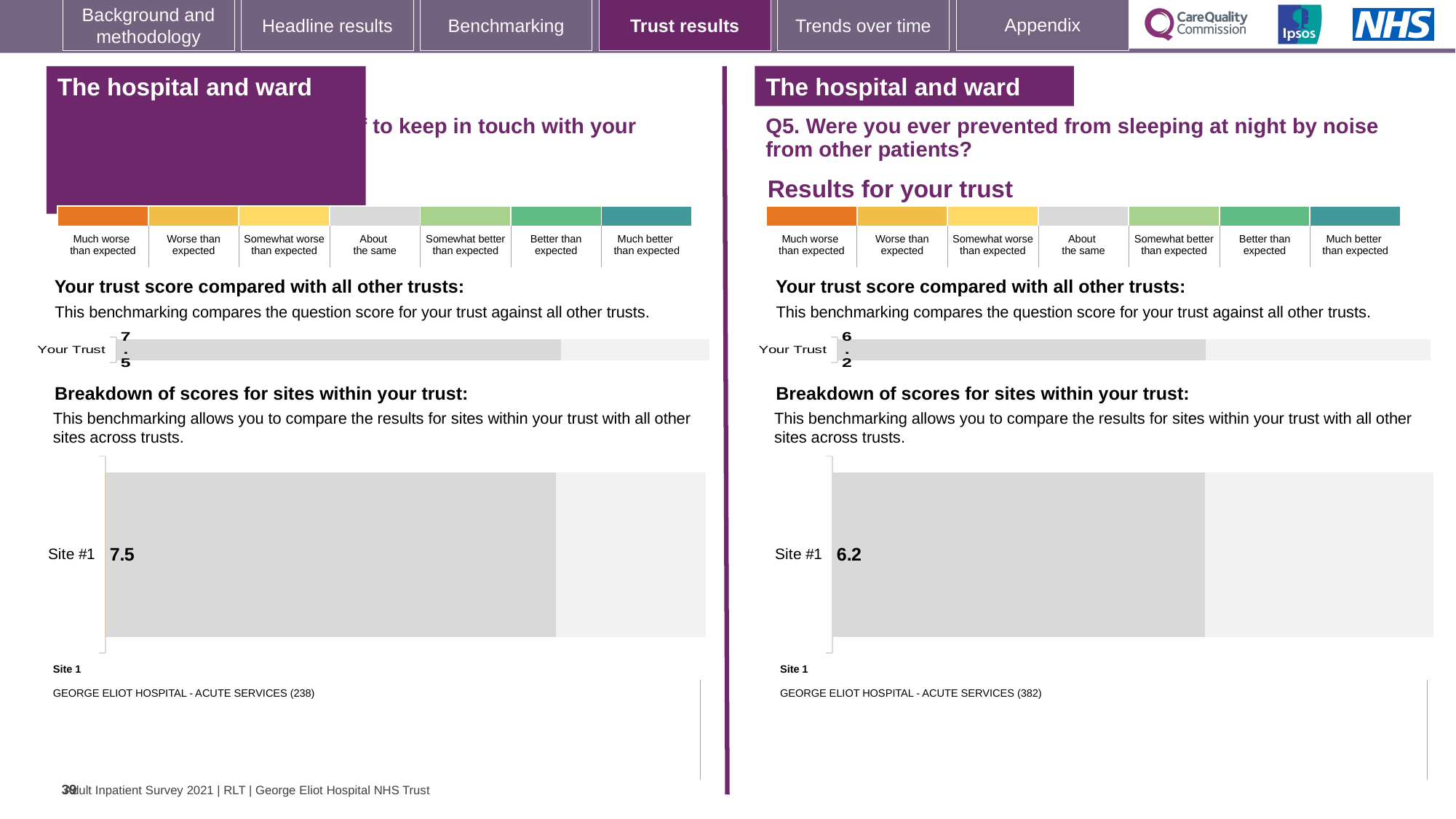
How many sites are shown in the right-hand site breakdown chart for Q5? 1 Which is larger: the Your Trust score on the left-hand chart or the Your Trust score on the right-hand Q5 chart? Left-hand chart (7.5) On the left-hand chart, what is the score shown for Your Trust? 7.5 On the right-hand chart for Q5 (prevented from sleeping at night by noise from other patients), what is the score shown for Your Trust? 6.2 What type of chart is used to show the Site #1 score on the right-hand Q5 panel? Bar chart In the right-hand site breakdown chart for Q5, what score is shown for Site #1? 6.2 How many sites are shown in the left-hand site breakdown chart? 1 What is the difference between the Site #1 score on the left-hand chart (7.5) and the Site #1 score on the right-hand Q5 chart (6.2)? 1.3 In the left-hand site breakdown chart, what score is shown for Site #1? 7.5 How many rating categories are shown in the colour key above the right-hand Q5 chart? 7 Which site is listed as Site 1 beneath the right-hand Q5 chart? GEORGE ELIOT HOSPITAL - ACUTE SERVICES (382)